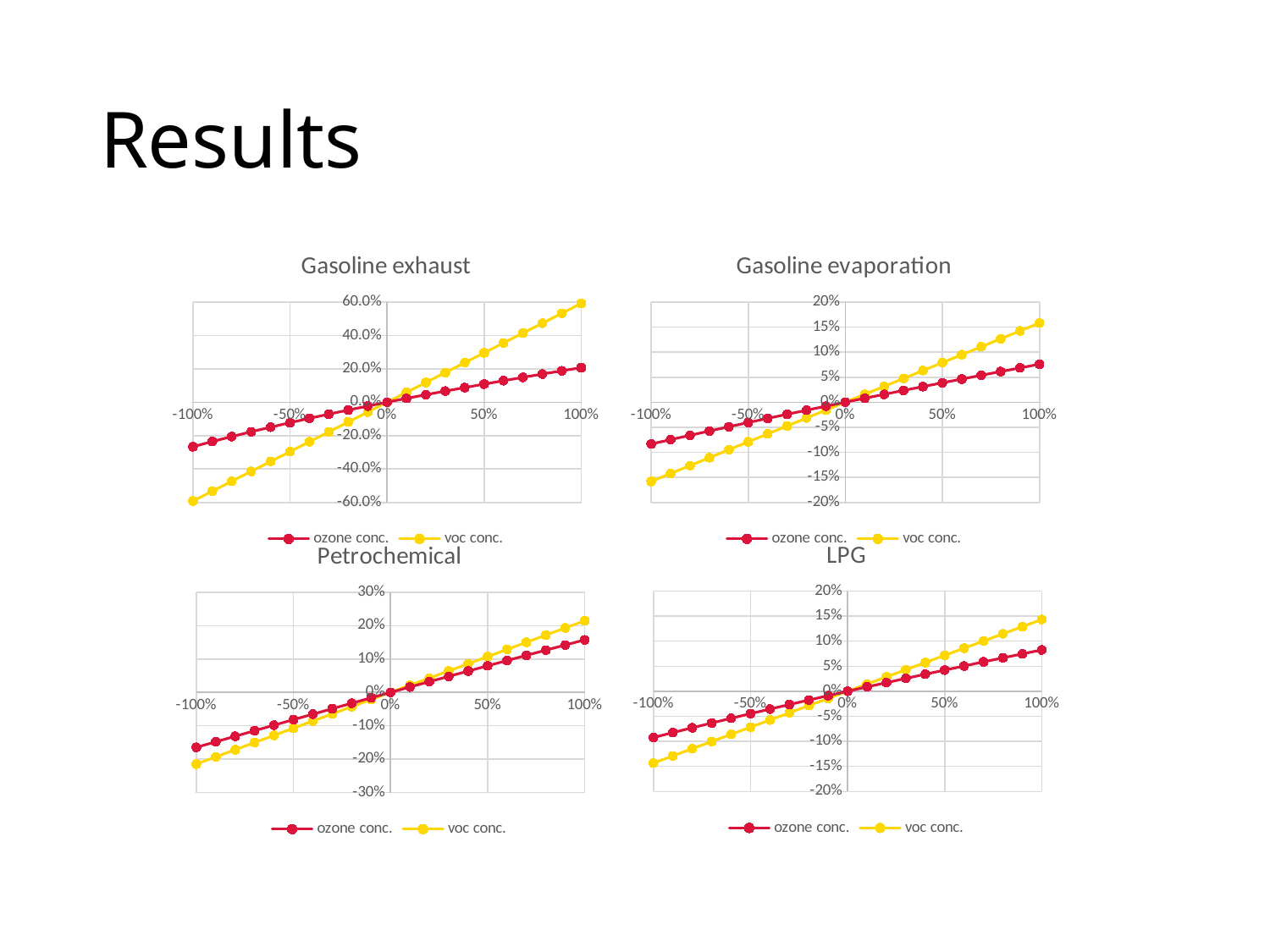
In the Gasoline exhaust chart, is the voc conc. value at 100% greater or less than 40.0%? greater How many series does the legend of the LPG chart list? 2 In the Petrochemical chart, is the ozone conc. value at -100% greater or less than -10%? less In the Gasoline evaporation chart, is the ozone conc. value at 100% greater or less than 5%? greater What colour is the ozone conc. series in the Petrochemical chart? red In the Gasoline exhaust chart, do the voc conc. values rise or fall as the x axis goes from -100% to 100%? rise What kind of chart is the Gasoline exhaust chart? line chart In the Gasoline exhaust chart, which series has the larger value at 100%, ozone conc. or voc conc.? voc conc. In the LPG chart, do the ozone conc. values rise or fall as the x axis goes from -100% to 100%? rise